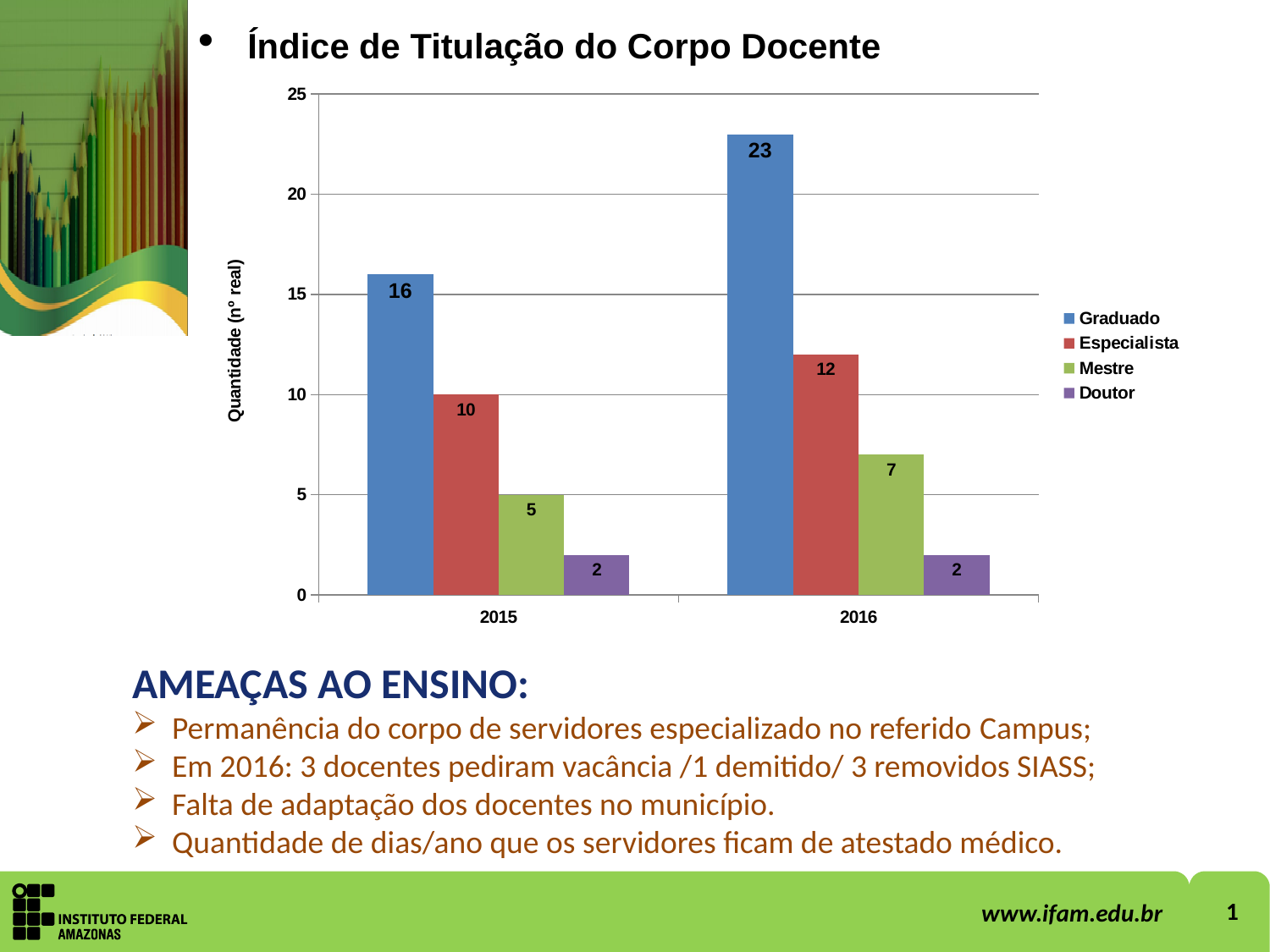
What is the label of the vertical axis? Quantidade (nº real) What is the value for Mestre in 2016? 7 What kind of chart is shown on the slide? Bar chart Which is larger, Especialista in 2016 or Mestre in 2016? Especialista in 2016 Which series has the highest value in 2016? Graduado What is the value for Especialista in 2015? 10 What is the value for Graduado in 2016? 23 Which series has the lowest value in 2015? Doutor How many series does the legend list? 4 What is the value for Doutor in 2015? 2 How many categories are shown on the x axis? 2 What is the difference between the Graduado values for 2016 and 2015? 7